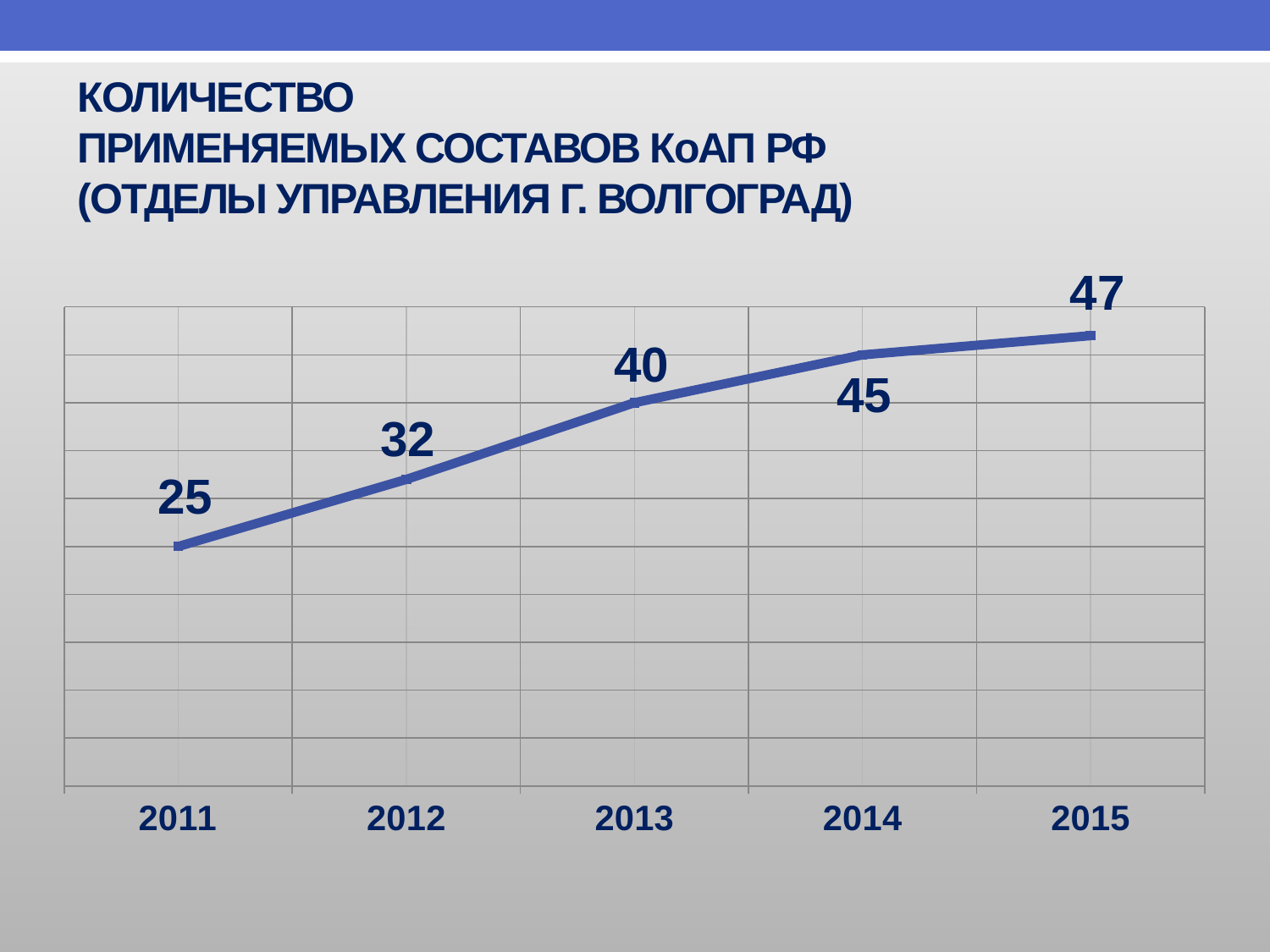
What is the difference between the values for 2015 and 2011? 22 What is the value for 2015? 47 Which year has the lowest value? 2011 What is the difference between the values for 2013 and 2012? 8 What is the value for 2014? 45 Do the values rise or fall from 2011 to 2015? rise How many years are plotted on the chart? 5 What kind of chart is shown on the slide? line chart What is the value for 2013? 40 Which is larger, the value for 2014 or the value for 2012? 2014 What is the value for 2011? 25 Which year has the highest value? 2015